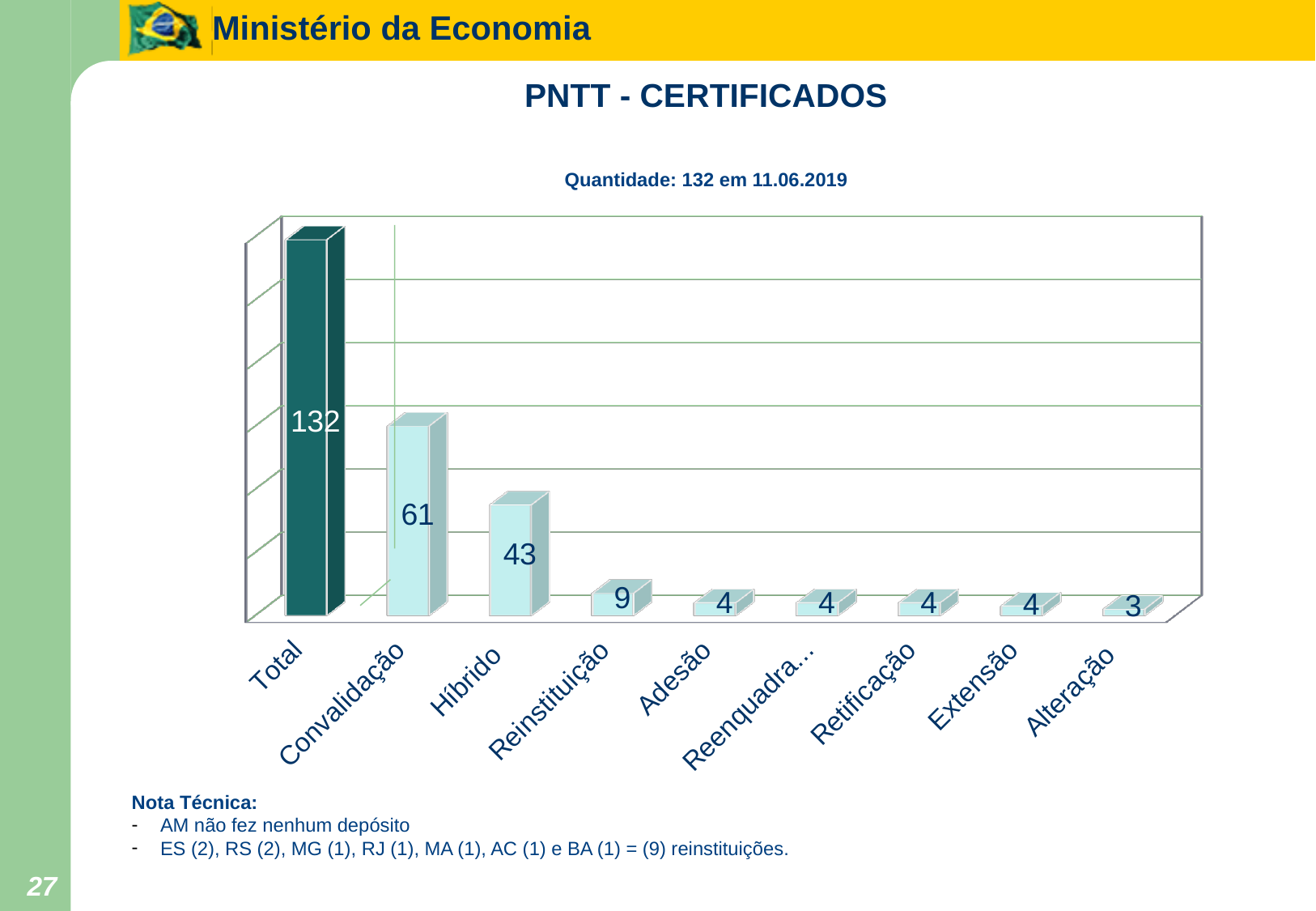
What is the value for Reinstituição? 9 Which category has the lowest value? Alteração What is the value shown for the Total bar? 132 What is the title printed above the chart? Quantidade: 132 em 11.06.2019 What is the value for Convalidação? 61 Which category has the highest value? Total What is the difference between the values for Convalidação and Híbrido? 18 Which is larger, the value for Híbrido or the value for Reinstituição? Híbrido What is the value for Alteração? 3 What kind of chart is shown on the slide? Bar chart How many categories are shown on the x axis? 9 What is the value for Híbrido? 43